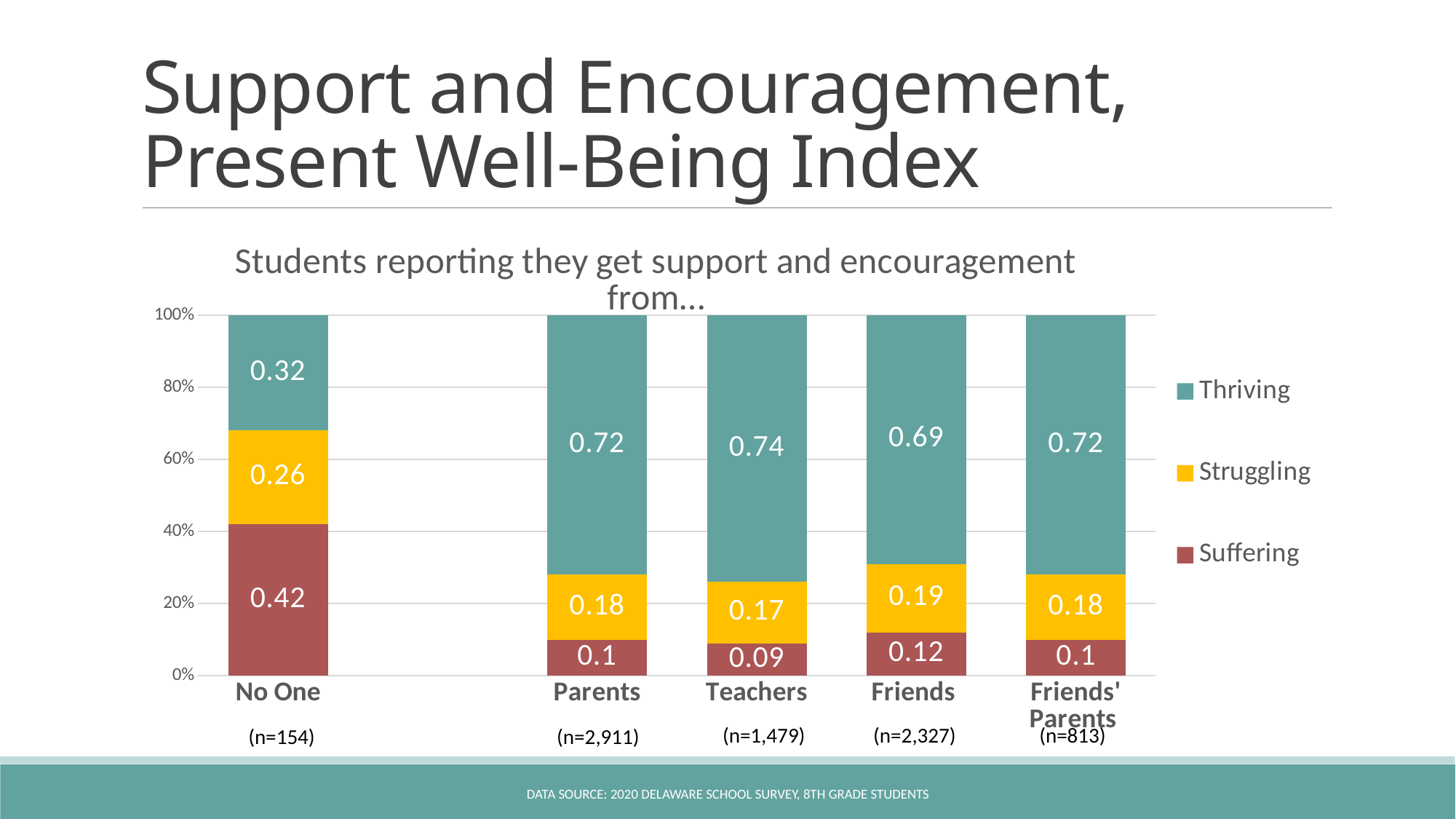
How many categories are shown on the x axis? 5 What is the Suffering value for No One? 0.42 Which colour represents the Struggling series in the legend? Yellow Which is larger, the Struggling value for No One or the Struggling value for Parents? No One What is the difference between the Thriving values for Teachers and No One? 0.42 What is the Thriving value for Teachers? 0.74 How many series does the legend list? 3 What kind of chart is shown on the slide? Stacked bar chart What is the Struggling value for Friends? 0.19 Which category has the highest Thriving value? Teachers What is the sample size (n) shown for Parents? n=2,911 Which category has the lowest Suffering value? Teachers